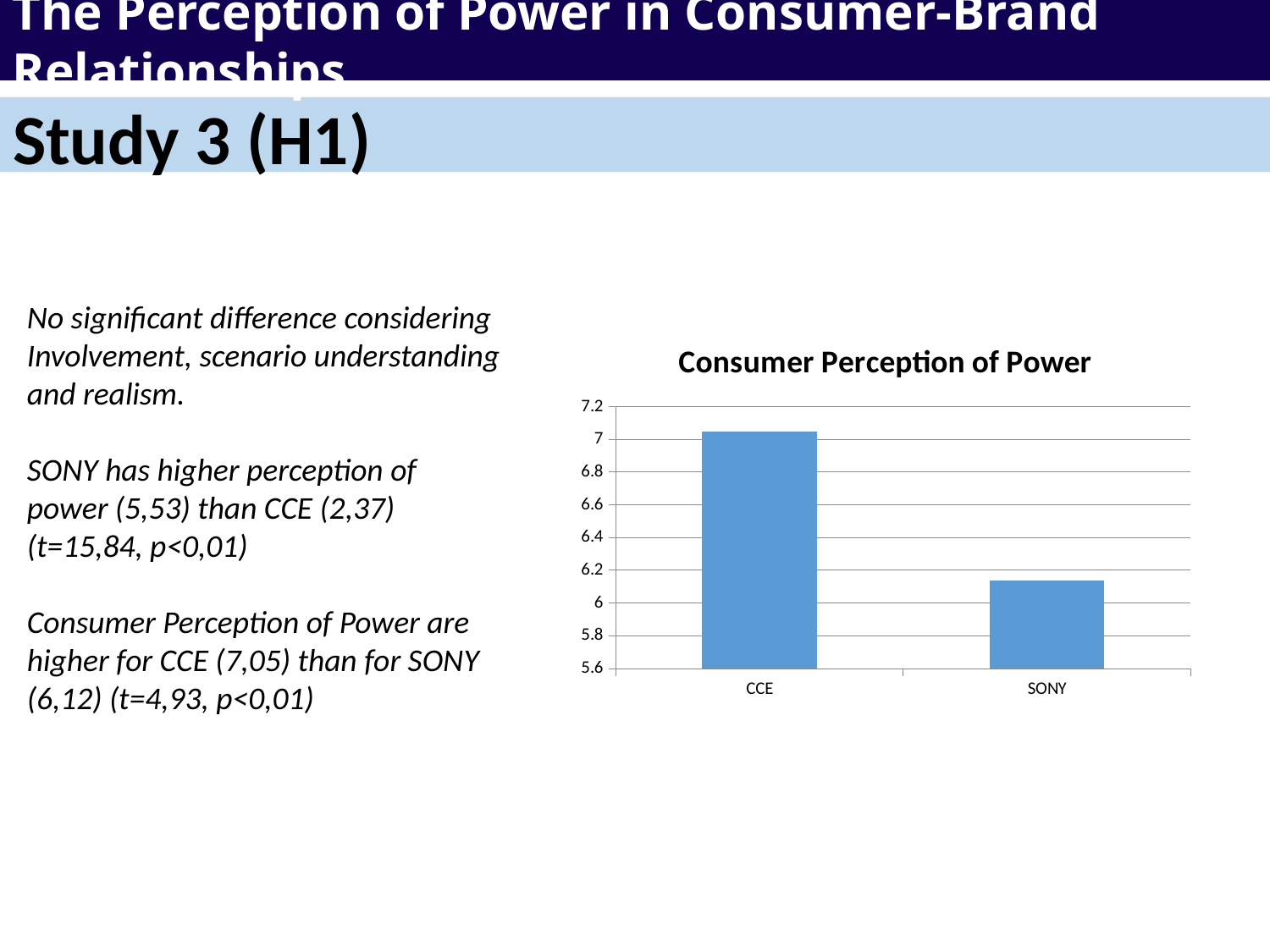
Do the bar values rise or fall from CCE to SONY along the x axis? fall What type of chart is shown on the slide? bar chart What is the title of the chart? Consumer Perception of Power Which category has the lowest bar in the chart? SONY How many categories are shown on the x axis of the chart? 2 Which is larger in the chart, the value for CCE or the value for SONY? CCE What is the lowest value shown on the y axis of the chart? 5.6 Is the value for CCE greater or less than 7? greater Is the value for CCE greater or less than 6.6? greater Is the value for SONY greater or less than 6? greater Which category has the highest bar in the chart? CCE